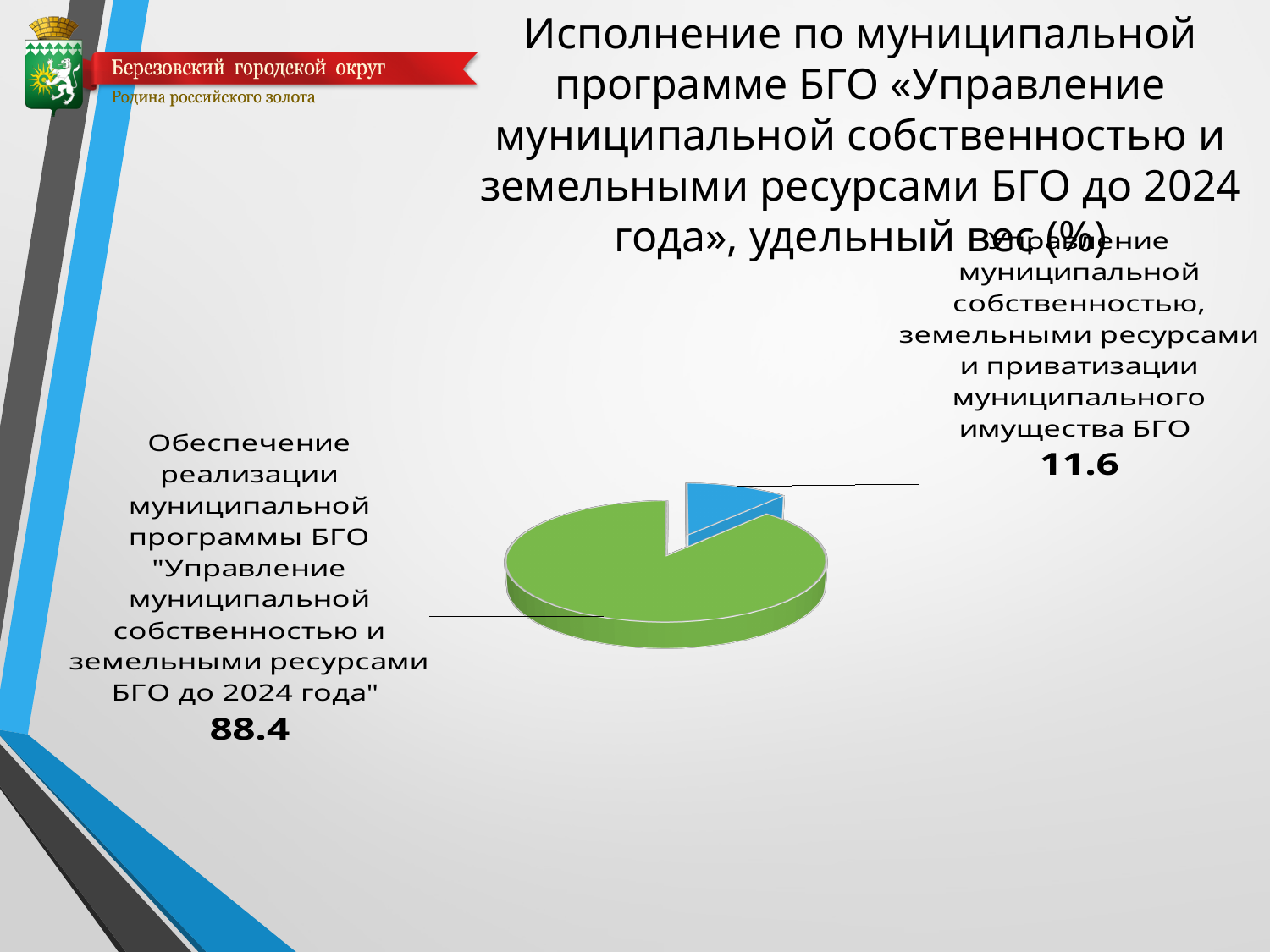
What colour is the slice with the value 88.4? green Which slice of the pie chart is the largest? Обеспечение реализации муниципальной программы БГО "Управление муниципальной собственностью и земельными ресурсами БГО до 2024 года" What colour is the slice with the value 11.6? blue What is the total of the two values shown on the pie chart? 100 Which slice of the pie chart is the smallest? Управление муниципальной собственностью, земельными ресурсами и приватизации муниципального имущества БГО What is the difference between the two slice values shown on the pie chart? 76.8 What is the value for the slice labelled "Обеспечение реализации муниципальной программы БГО "Управление муниципальной собственностью и земельными ресурсами БГО до 2024 года""? 88.4 What is the value for the slice labelled "Управление муниципальной собственностью, земельными ресурсами и приватизации муниципального имущества БГО"? 11.6 How many slices does the pie chart have? 2 What kind of chart is shown on the slide? pie chart Which is larger: the value for "Обеспечение реализации муниципальной программы БГО..." or the value for "Управление муниципальной собственностью, земельными ресурсами и приватизации муниципального имущества БГО"? Обеспечение реализации муниципальной программы БГО...